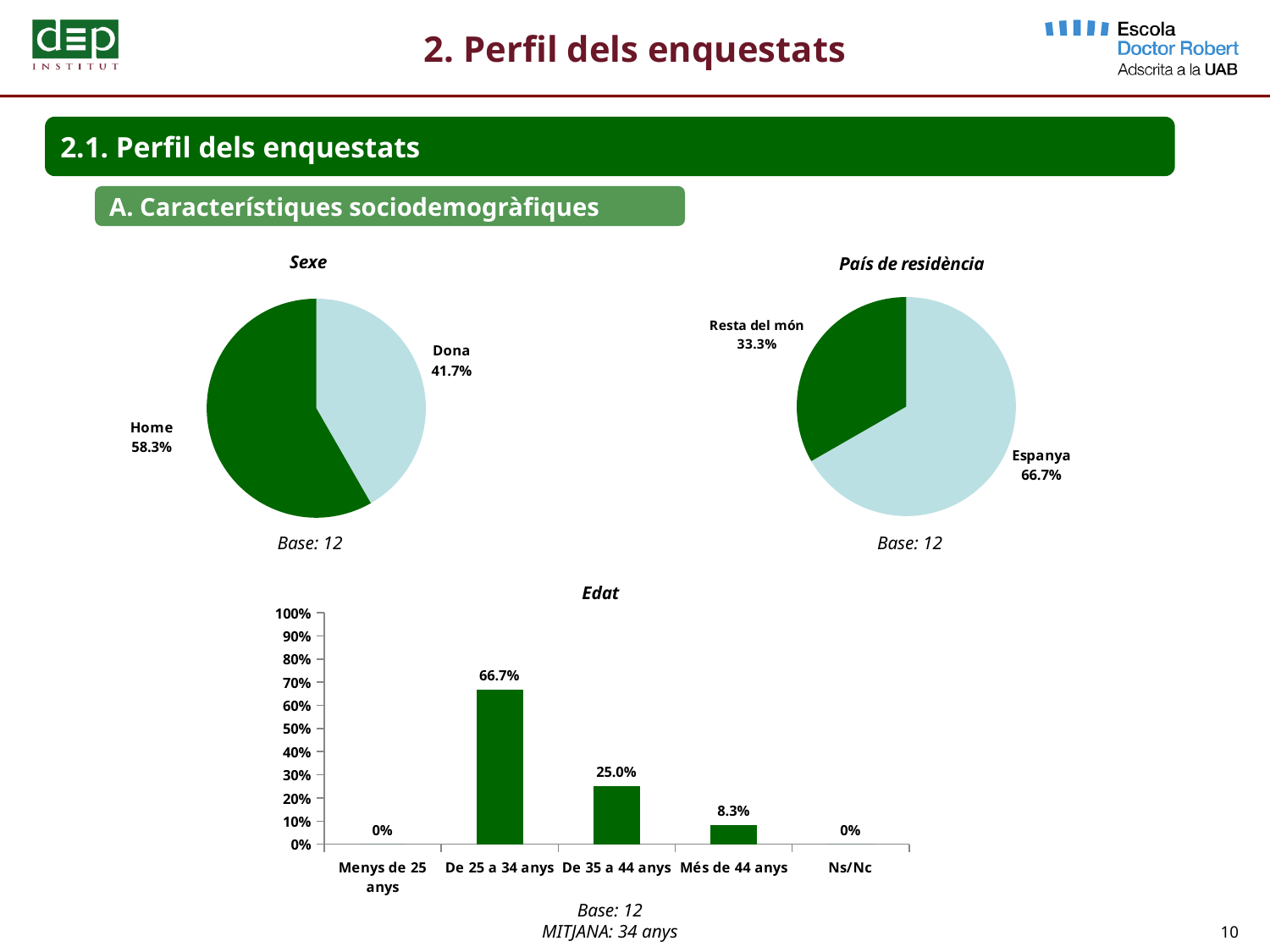
In the 'Edat' bar chart, what is the value for De 25 a 34 anys? 66.7% In the 'Sexe' pie chart, what percentage is shown for Dona? 41.7% In the 'País de residència' pie chart, what is the difference between the Espanya and Resta del món shares? 33.4% In the 'Edat' bar chart, which category has the highest value? De 25 a 34 anys In the 'Sexe' pie chart, what percentage is shown for Home? 58.3% In the 'País de residència' pie chart, what percentage is shown for Resta del món? 33.3% In the 'Edat' bar chart, how many categories are shown on the x axis? 5 In the 'Sexe' pie chart, which category has the larger share? Home In the 'Edat' bar chart, what is the difference between De 25 a 34 anys and De 35 a 44 anys? 41.7% In the 'Edat' bar chart, what is the value for Més de 44 anys? 8.3% In the 'País de residència' pie chart, what percentage is shown for Espanya? 66.7% What type of chart is the 'Edat' chart? Bar chart